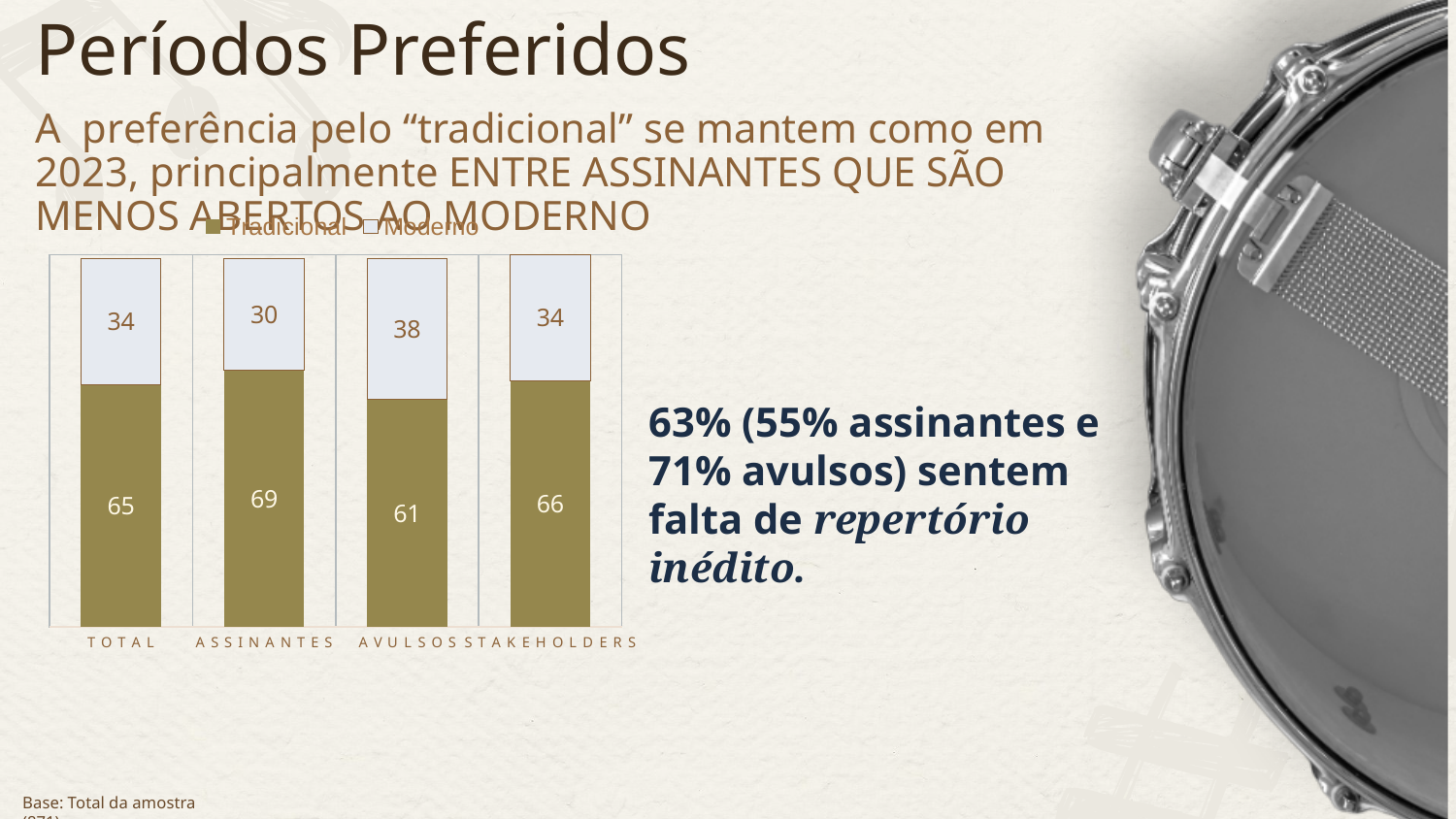
How many categories are shown on the x axis? 4 Which category has the lowest Tradicional value? AVULSOS Which is larger, the Tradicional value for STAKEHOLDERS or for TOTAL? STAKEHOLDERS What kind of chart is shown on the slide? Stacked bar chart What is the Tradicional value for TOTAL? 65 What is the Moderno value for AVULSOS? 38 What is the difference between the Tradicional values for ASSINANTES and AVULSOS? 8 Which category has the highest Tradicional value? ASSINANTES What is the Moderno value for STAKEHOLDERS? 34 Which category has the highest Moderno value? AVULSOS How many series does the legend list? 2 What is the Tradicional value for ASSINANTES? 69